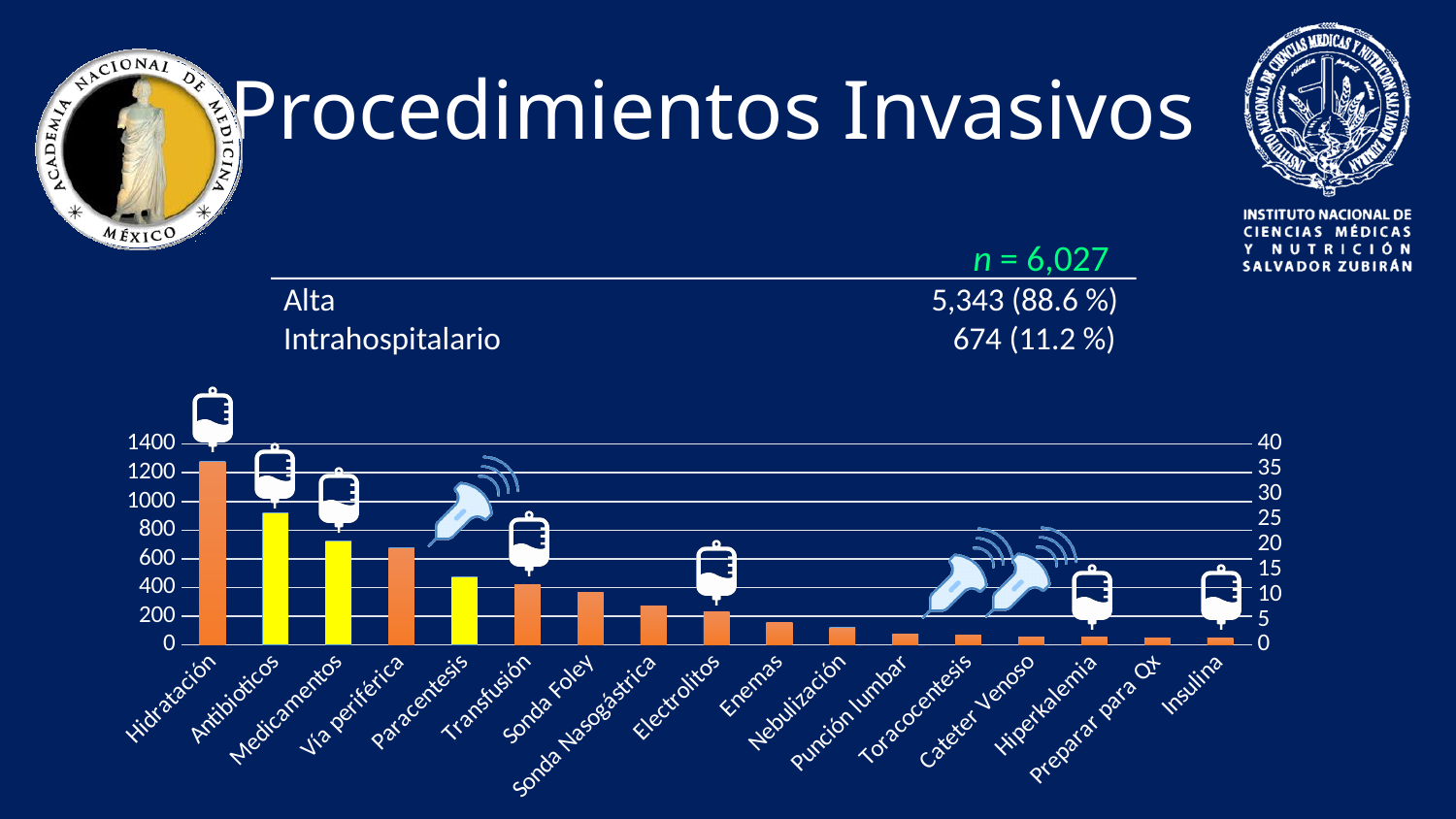
Which is larger, the value for Antibióticos or the value for Medicamentos? Antibióticos Is the value for Hidratación greater or less than 1200? greater Do the bar values rise or fall moving from left to right along the x axis? fall Is the value for Enemas greater or less than 200? less Which category has the highest bar in the chart? Hidratación Which three categories are drawn with yellow bars instead of orange? Antibióticos, Medicamentos, Paracentesis What kind of chart is shown on the slide? bar chart Is the value for Medicamentos greater or less than 600? greater Which is larger, the value for Paracentesis or the value for Sonda Foley? Paracentesis How many categories are plotted on the x axis of the chart? 17